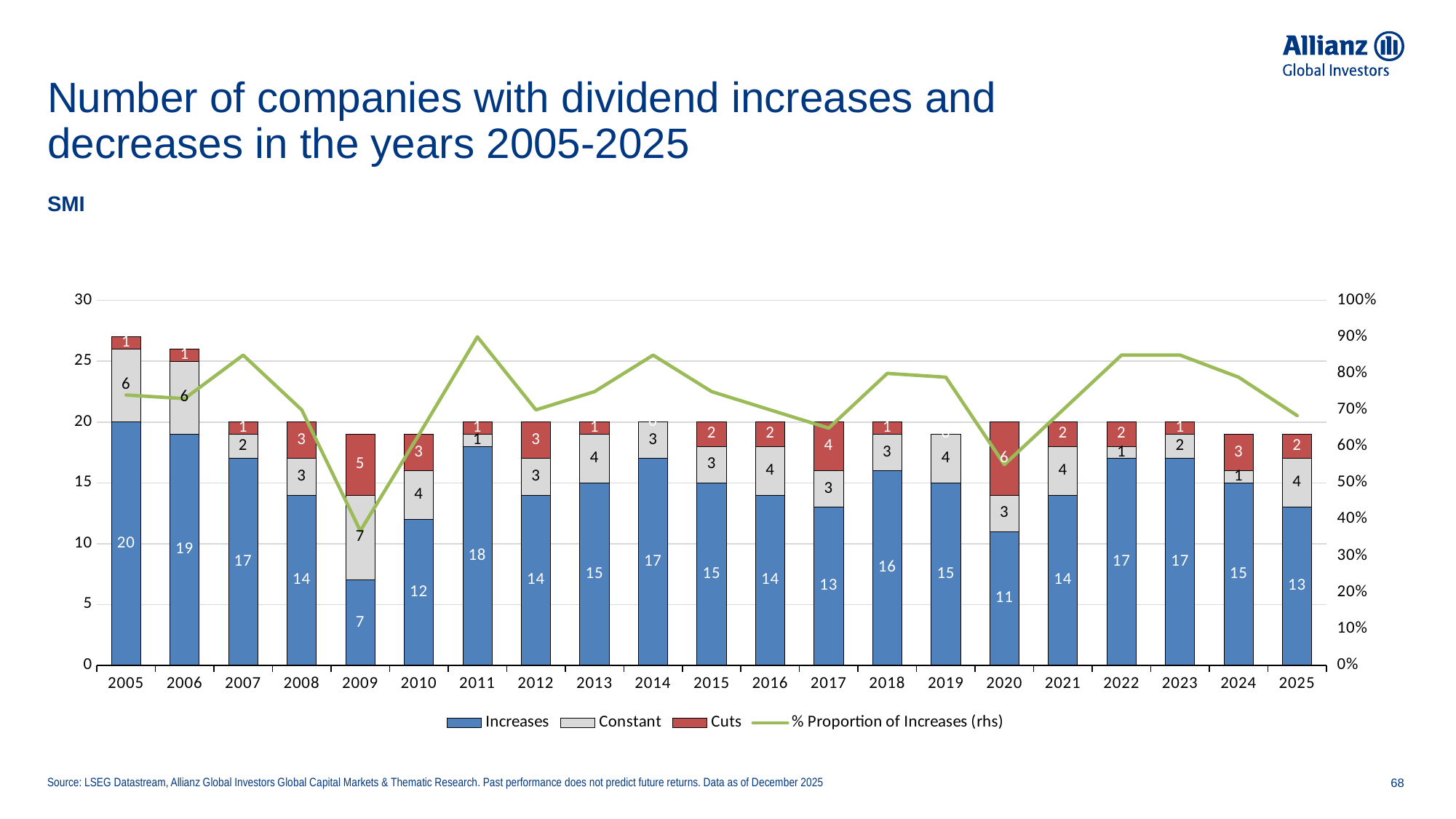
How many years are shown on the x axis? 21 Which year has the highest number of dividend cuts? 2020 What is the value of the Cuts series in 2020? 6 What is the value of the Constant series in 2006? 6 Is the % Proportion of Increases in 2011 greater or less than 80%? greater Which is larger, the number of increases in 2011 or in 2017? 2011 Which year has the lowest number of dividend increases? 2009 What is the total height of the stacked bar for 2005? 27 Which year has the highest number of dividend increases? 2005 How many series does the legend list? 4 How many companies had dividend increases in 2009? 7 What is the difference between the number of increases in 2005 and in 2009? 13